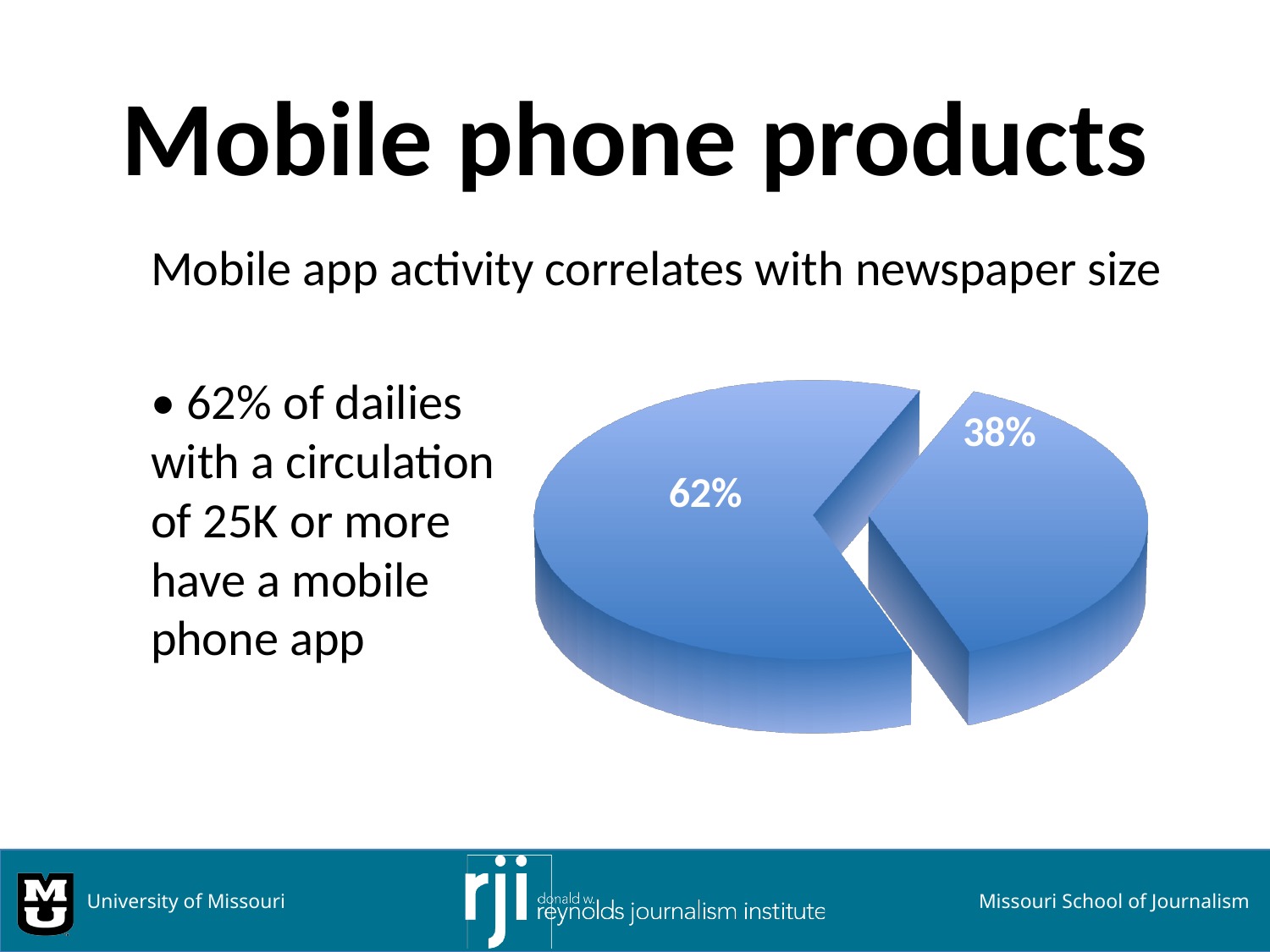
Is the larger slice of the pie chart greater or less than 50%? greater Which slice is larger, the 62% slice or the 38% slice? the 62% slice What is the title of the slide containing the pie chart? Mobile phone products What do the two slices of the pie chart add up to? 100% What share does the largest slice of the pie chart represent? 62% Is the smaller slice of the pie chart greater or less than 50%? less What is the difference in percentage points between the two slices of the pie chart? 24 What kind of chart is shown on the slide? pie chart Which slice of the pie chart is pulled out (exploded) from the rest? the 38% slice What share does the smallest slice of the pie chart represent? 38% According to the slide, what percentage of dailies with a circulation of 25K or more have a mobile phone app? 62% How many slices does the pie chart have? 2